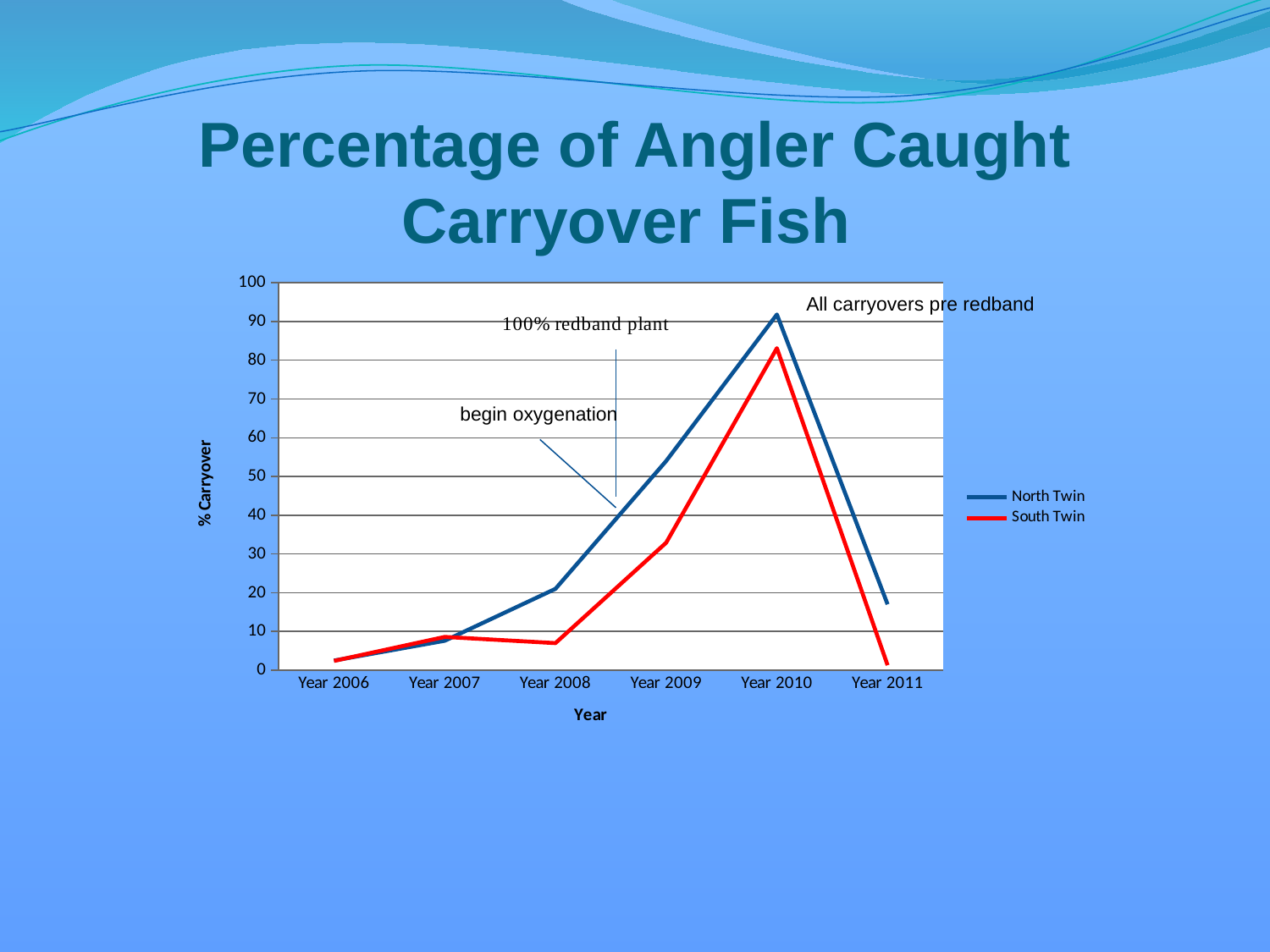
In which year does the South Twin series reach its highest value? Year 2010 What is the title of the slide's chart? Percentage of Angler Caught Carryover Fish Is the South Twin value for Year 2008 greater or less than 10? less Is the North Twin value for Year 2009 greater or less than 40? greater Is the North Twin value for Year 2010 greater or less than 80? greater Which series has the larger value in Year 2009, North Twin or South Twin? North Twin How many years are shown on the x axis? 6 How many series does the legend list? 2 What kind of chart is shown on the slide? line chart Which series has the larger value in Year 2011, North Twin or South Twin? North Twin Do the North Twin values rise or fall from Year 2006 to Year 2010? rise In which year does the North Twin series reach its highest value? Year 2010